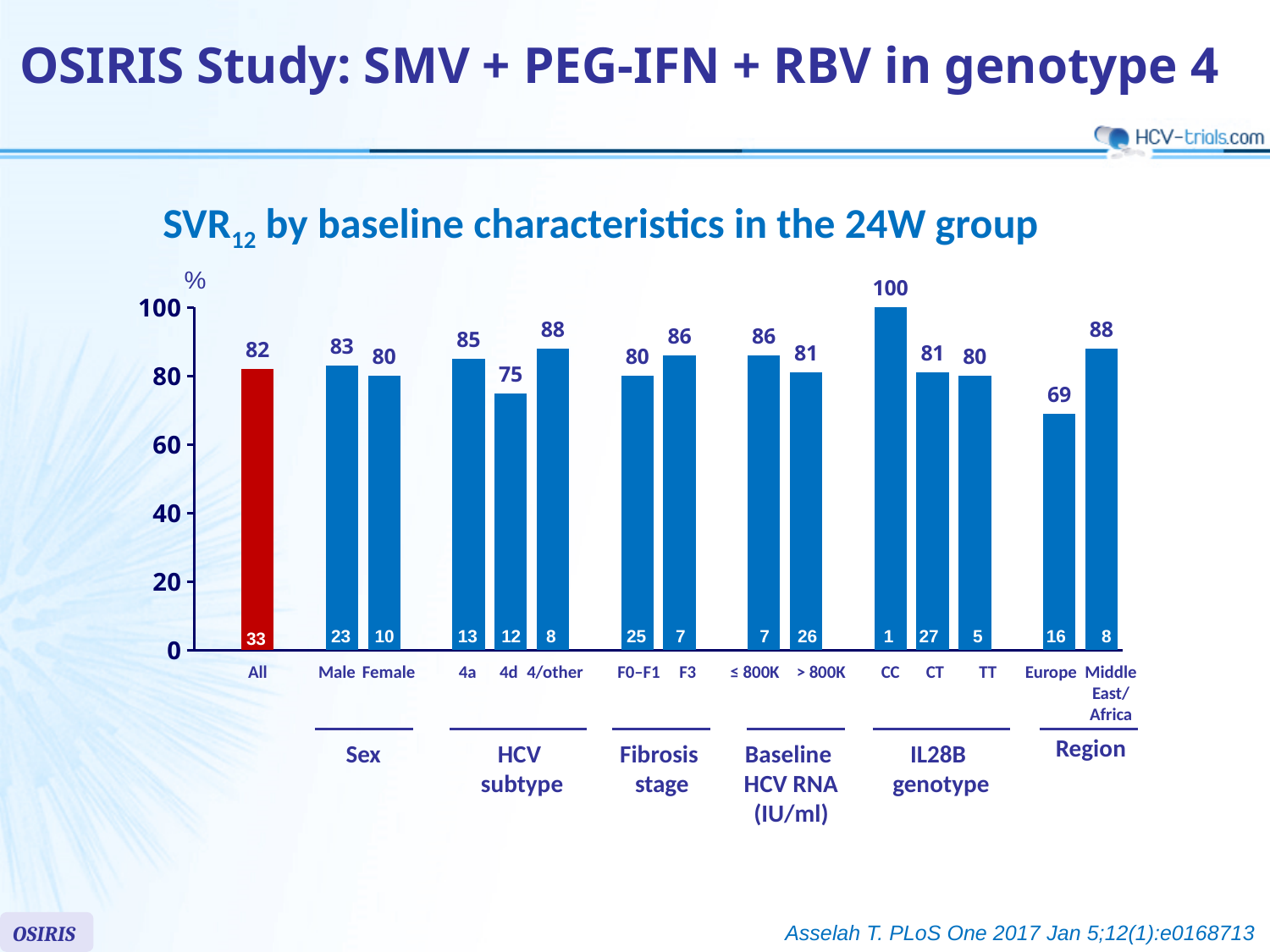
What is the SVR12 value for the 4d HCV subtype subgroup? 75 What is the difference in SVR12 between the Middle East/Africa and Europe subgroups? 19 Which subgroup has the lowest SVR12 value? Europe How many bars are plotted in the chart? 15 What is the SVR12 value for the All group? 82 Which subgroup has the highest SVR12 value? CC What is the difference in SVR12 between the 4a and 4d subtype subgroups? 10 Which bar is coloured red rather than blue? All What type of chart is shown on the slide? Bar chart How many patients are in the Male subgroup, as shown at the base of the bar? 23 Which has a higher SVR12 value, the F0–F1 or the F3 subgroup? F3 What is the SVR12 value for the Female subgroup? 80